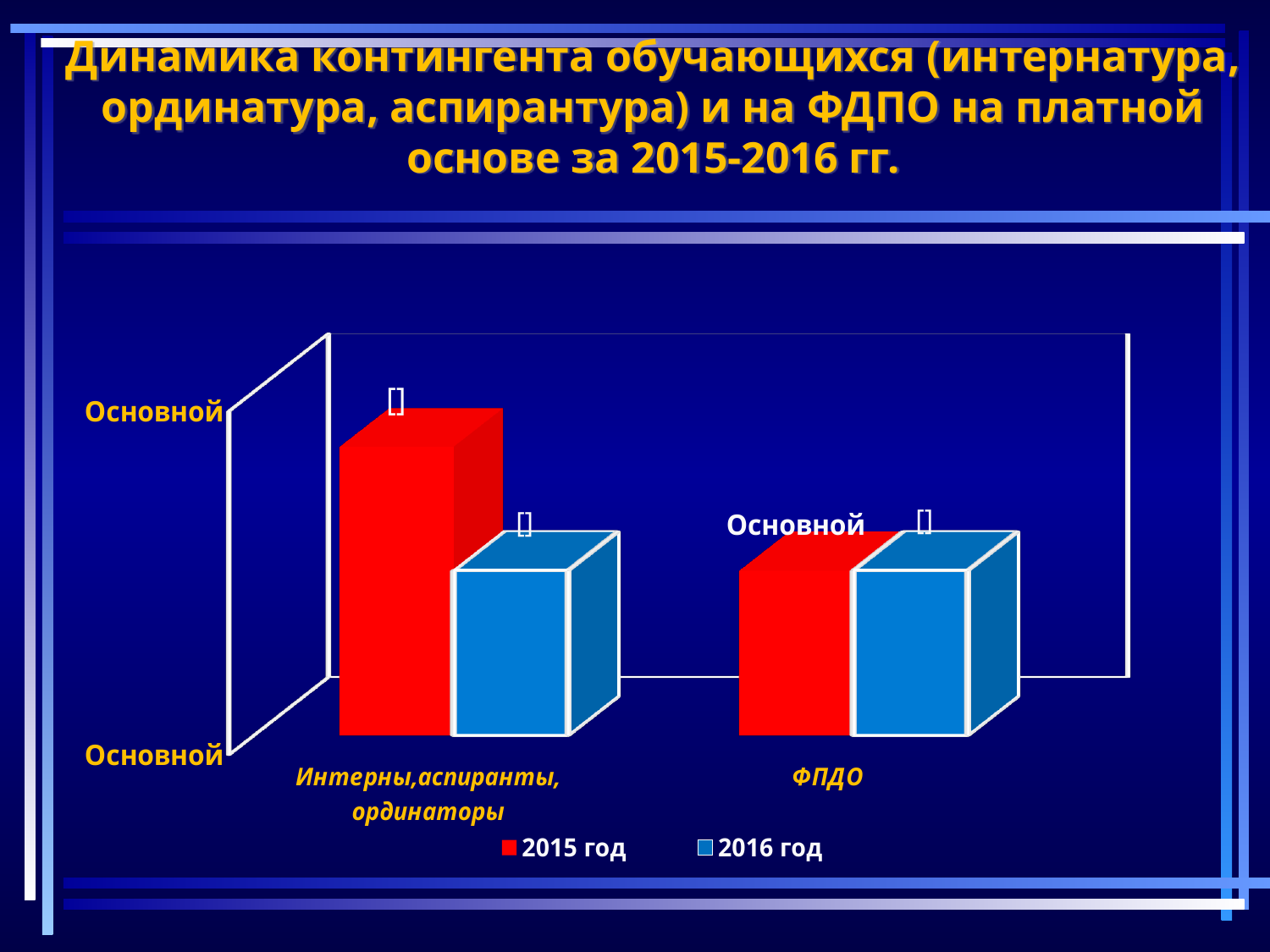
How many categories are shown on the x axis? 2 Which series is shown in red in the legend? 2015 год What kind of chart is shown on the slide? Bar chart Which category has the lowest value for the 2015 год series? ФПДО How many series does the legend list? 2 For the category "Интерны,аспиранты, ординаторы", which is larger: the 2015 год value or the 2016 год value? 2015 год Which series is shown in blue in the legend? 2016 год Which category has the highest value for the 2015 год series? Интерны,аспиранты, ординаторы Which is larger: the 2015 год value for "Интерны,аспиранты, ординаторы" or the 2015 год value for "ФПДО"? Интерны,аспиранты, ординаторы For the 2015 год series, do the values rise or fall from "Интерны,аспиранты, ординаторы" to "ФПДО"? Fall Which is larger: the 2015 год value for "Интерны,аспиранты, ординаторы" or the 2016 год value for "ФПДО"? 2015 год value for Интерны,аспиранты, ординаторы